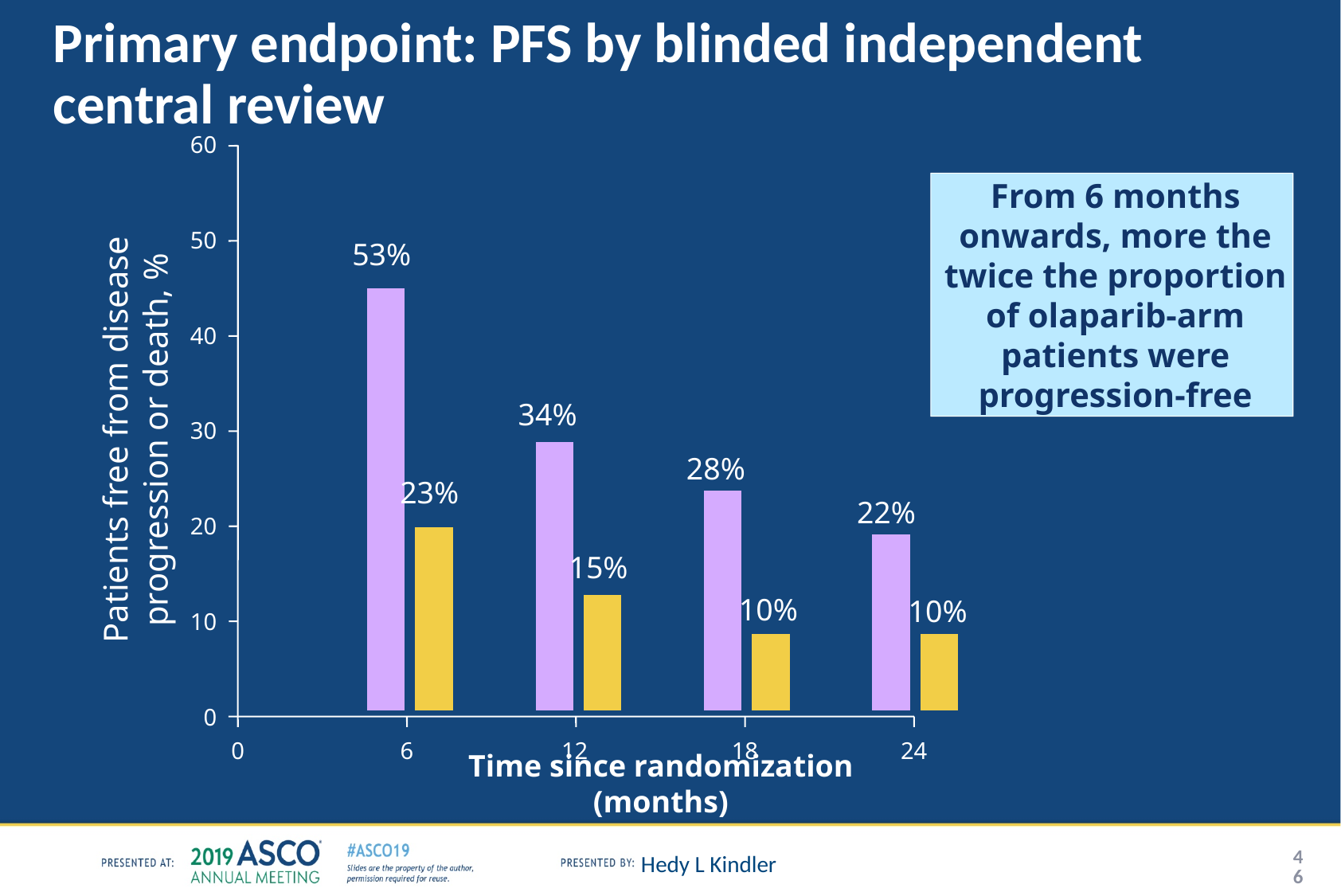
At which time point is the purple bar highest? 6 months What is the value of the purple bar at 24 months? 22% How many time points are shown on the x axis with bars? 4 What is the value of the yellow bar at 12 months? 15% What is the value of the purple bar at 6 months? 53% What kind of chart is shown on the slide? bar chart Do the purple bar values rise or fall as time since randomization increases? fall Which is larger at 18 months, the purple bar or the yellow bar? the purple bar What is the difference between the purple and yellow bars at 6 months? 30% At which time point is the purple bar lowest? 24 months What is the label of the y axis? Patients free from disease progression or death, % What is the value of the yellow bar at 18 months? 10%